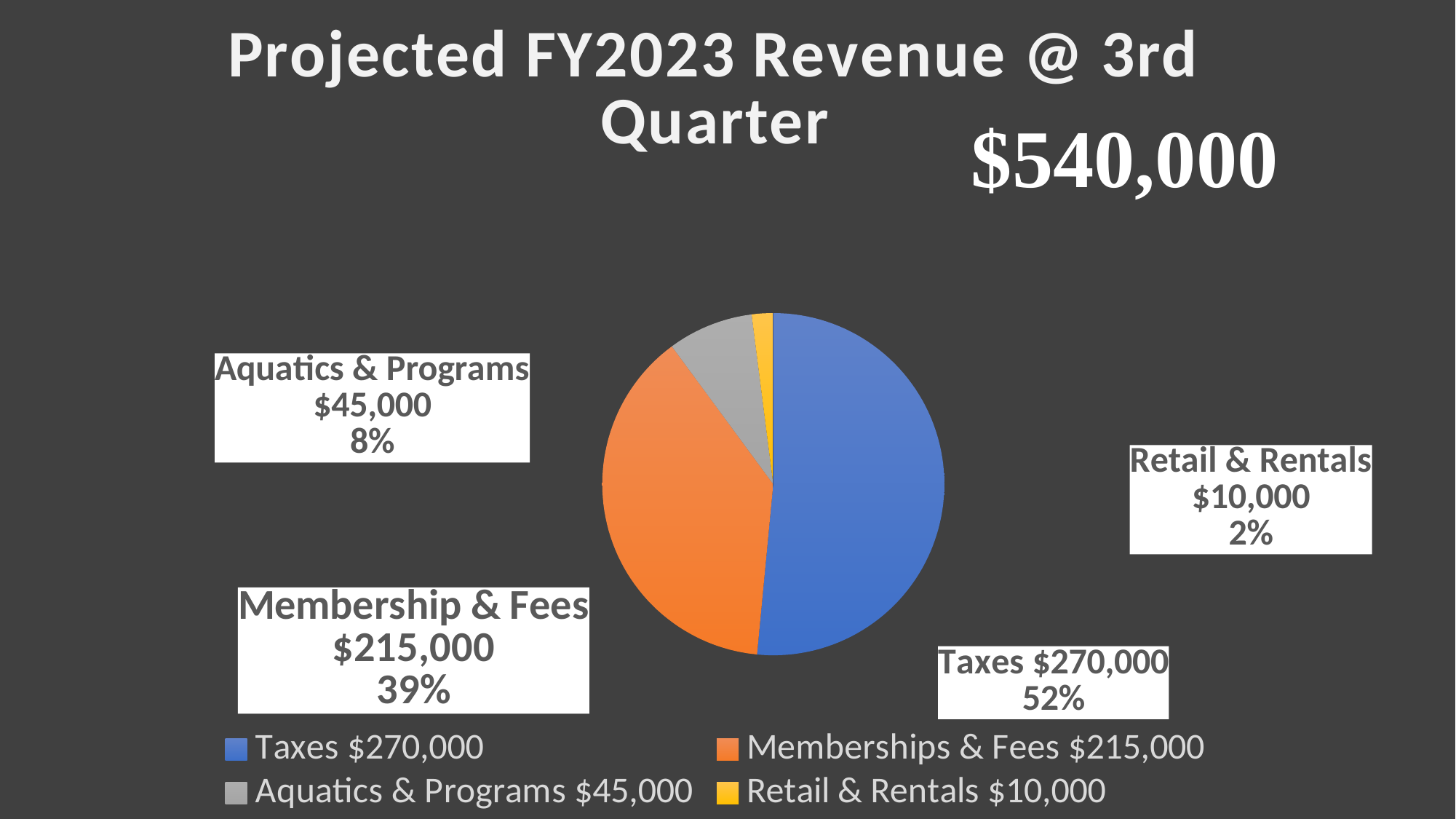
Which category has the smallest slice of the pie? Retail & Rentals What percentage share of the pie does Membership & Fees represent? 39% How many categories are shown in the pie chart? 4 Which is larger, the value for Aquatics & Programs or the value for Retail & Rentals? Aquatics & Programs What is the projected revenue value for Taxes? $270,000 What type of chart is shown on the slide? Pie chart Which category has the largest slice of the pie? Taxes What is the title of the chart? Projected FY2023 Revenue @ 3rd Quarter What total revenue figure is displayed on the slide? $540,000 What is the difference between the Taxes value and the Membership & Fees value? $55,000 What is the projected revenue value for Aquatics & Programs? $45,000 What percentage share of the pie does Retail & Rentals represent? 2%